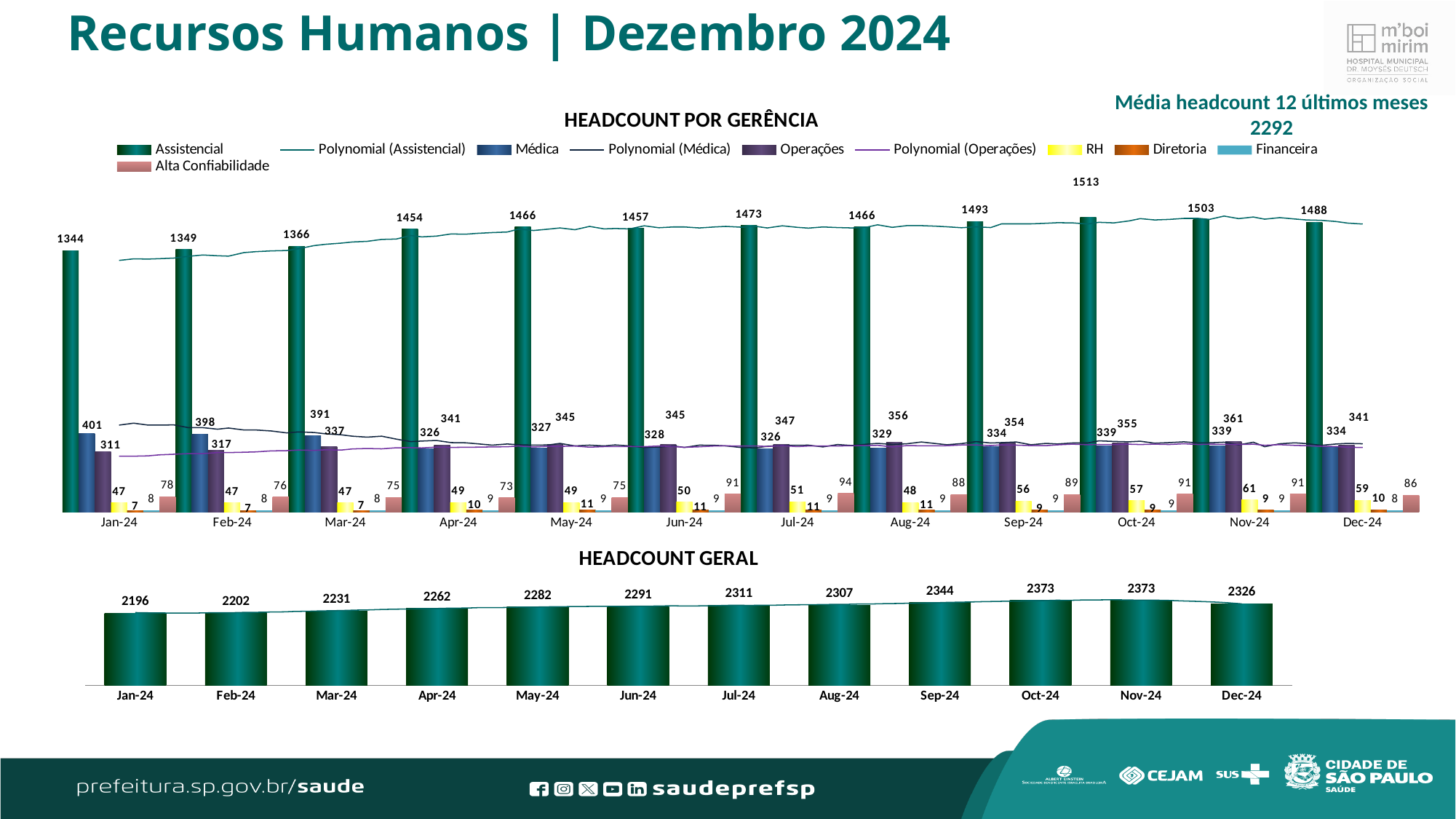
How many months are shown on the x axis of the HEADCOUNT GERAL chart? 12 In the HEADCOUNT GERAL chart, what is the difference between the values for Nov-24 and Dec-24? 47 In the HEADCOUNT POR GERÊNCIA chart, which month has the highest Assistencial value? Oct-24 How many series does the legend of the HEADCOUNT POR GERÊNCIA chart list? 10 In the HEADCOUNT POR GERÊNCIA chart, which is larger in Mar-24: Médica or Operações? Médica In the HEADCOUNT POR GERÊNCIA chart, what is the Assistencial value for Oct-24? 1513 In the HEADCOUNT GERAL chart, what is the value for Sep-24? 2344 In the HEADCOUNT POR GERÊNCIA chart, which month has the lowest Alta Confiabilidade value? Apr-24 In the HEADCOUNT GERAL chart, which month has the lowest value? Jan-24 In the HEADCOUNT POR GERÊNCIA chart, what is the difference between the Assistencial values for Dec-24 and Jan-24? 144 In the HEADCOUNT POR GERÊNCIA chart, what is the Médica value for Jan-24? 401 In the HEADCOUNT POR GERÊNCIA chart, what is the Operações value for Nov-24? 361